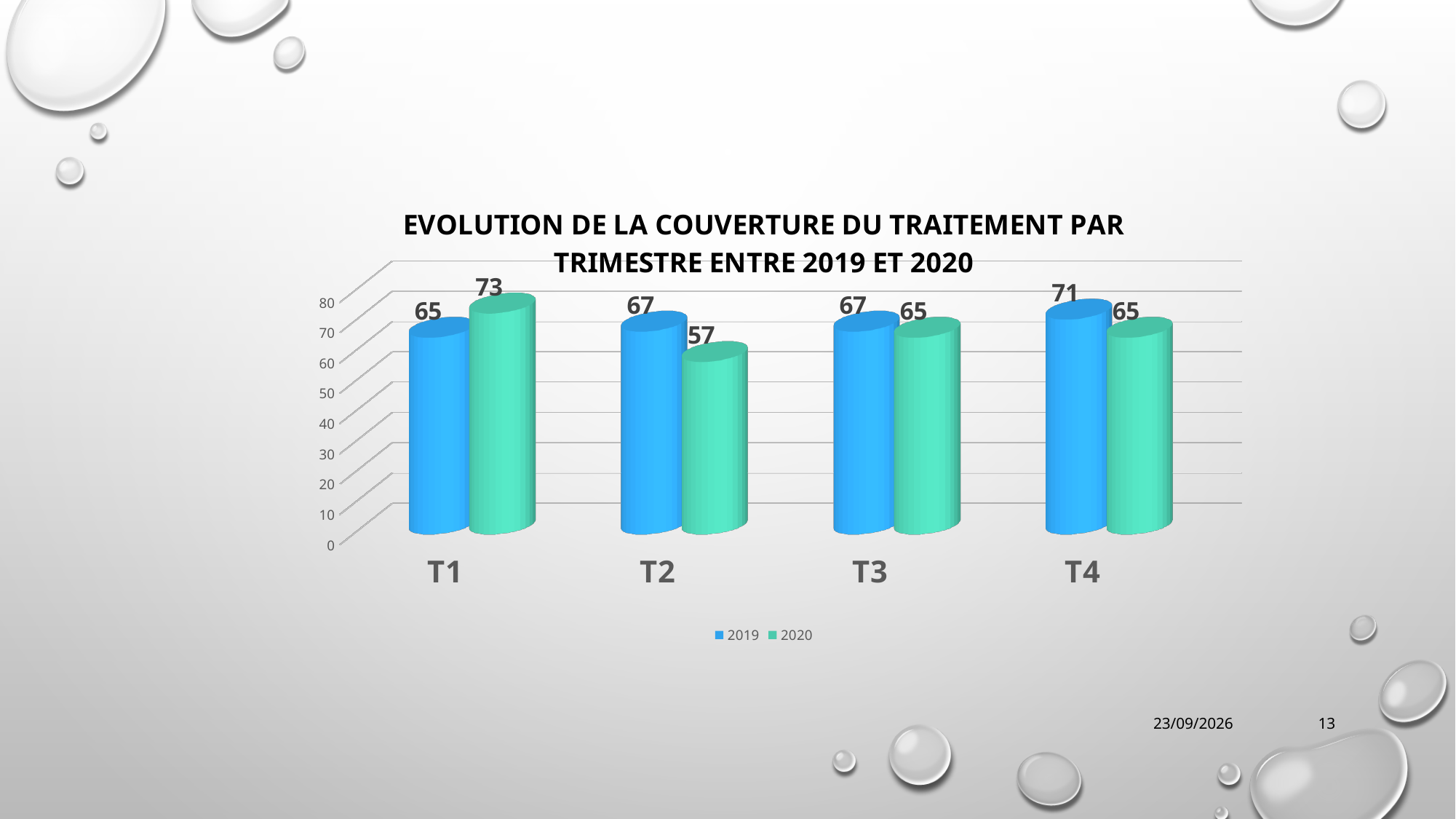
What is the value for 2019 in T1? 65 What kind of chart is shown on the slide? Bar chart How many quarters are shown on the x axis? 4 What is the difference between the 2020 value in T1 and the 2020 value in T2? 16 In T3, which series has the larger value, 2019 or 2020? 2019 Which quarter has the lowest value for the 2020 series? T2 Which quarter has the highest value for the 2020 series? T1 How many series does the legend list? 2 What is the value for 2020 in T2? 57 Which quarter has the highest value for the 2019 series? T4 What is the difference between the 2019 and 2020 values in T2? 10 What is the value for 2019 in T4? 71